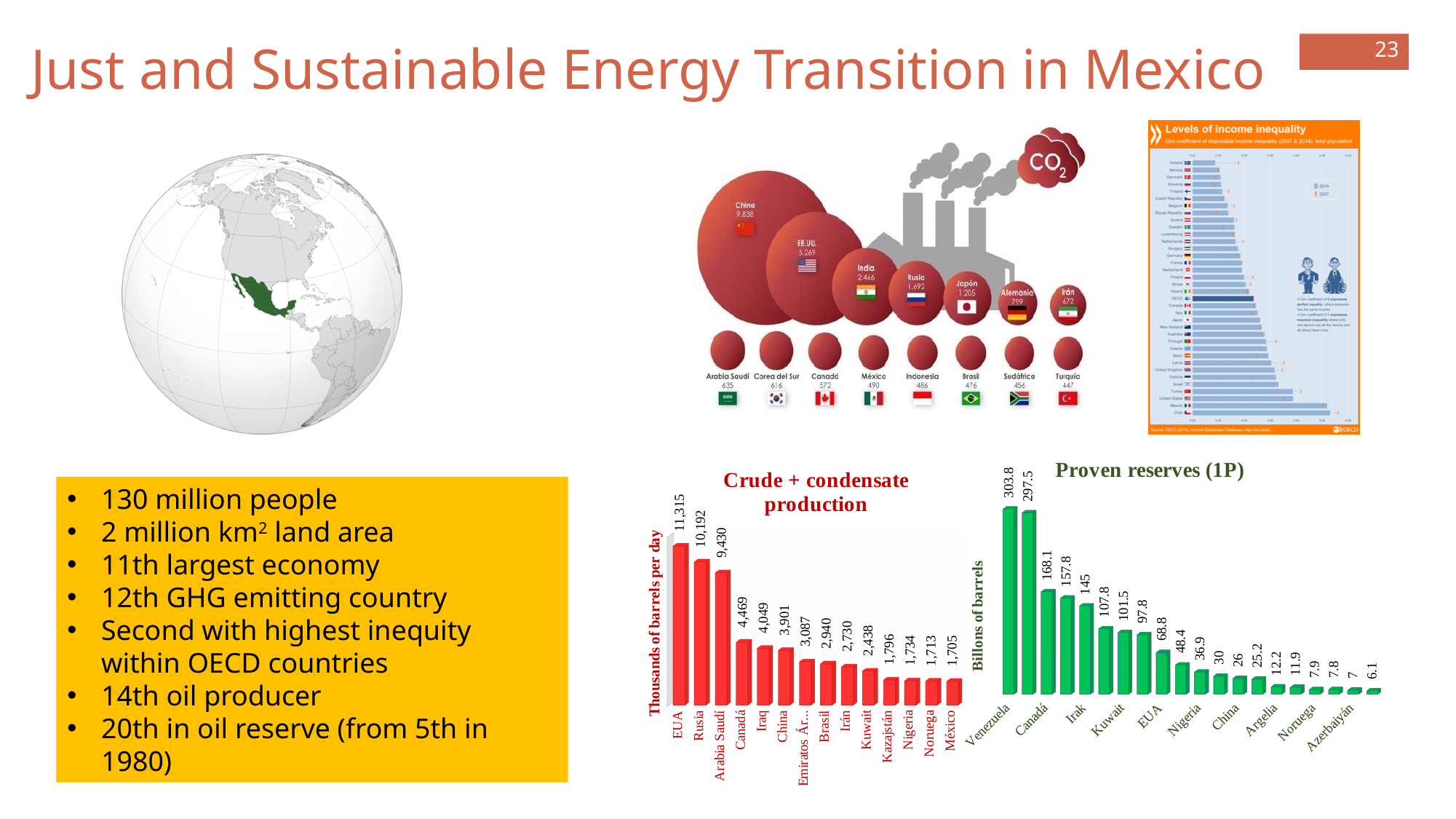
In the Crude + condensate production chart, what is the value for México? 1,705 In the Crude + condensate production chart, which country has the highest production? EUA In the Crude + condensate production chart, what is the difference between Rusia and Canadá? 5,723 In the Proven reserves (1P) chart, which labelled country has the highest reserves? Venezuela In the Crude + condensate production chart, what is the value for Arabia Saudí? 9,430 In the Proven reserves (1P) chart, which is larger, Canadá or EUA? Canadá In the CO2 emissions bubble chart, what is the value shown for México? 490 In the Proven reserves (1P) chart, what is the value for Kuwait? 101.5 In the Proven reserves (1P) chart, what is the value for Venezuela? 303.8 What kind of chart is the Crude + condensate production chart? Bar chart How many countries are shown in the Crude + condensate production chart? 14 In the Proven reserves (1P) chart, do the values rise or fall from left to right? Fall